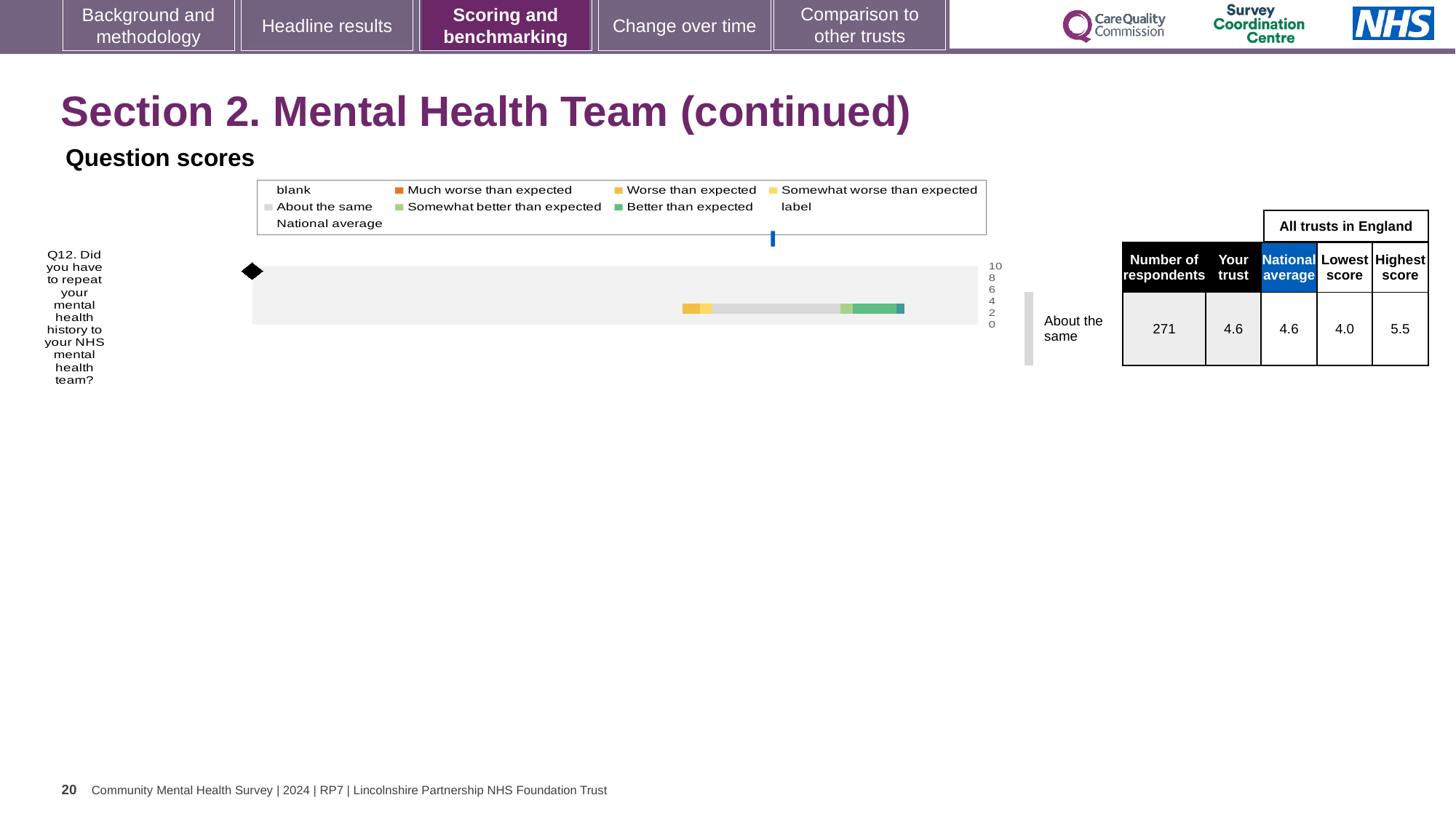
How many survey questions are plotted in the 'Question scores' chart? 1 What is the difference between the highest score and the lowest score for Q12? 1.5 What is the national average score for Q12? 4.6 What is the lowest score among all trusts in England for Q12? 4.0 What is the 'Your trust' score for Q12 in the table beside the chart? 4.6 How many entries does the legend of the 'Question scores' chart list? 9 What is the heading above the chart? Question scores What kind of chart is shown under 'Question scores'? bar chart Which benchmark category is the trust's Q12 result labelled as next to the chart? About the same What colour does the legend use for 'Much worse than expected'? orange How many respondents answered Q12? 271 What is the highest score among all trusts in England for Q12? 5.5